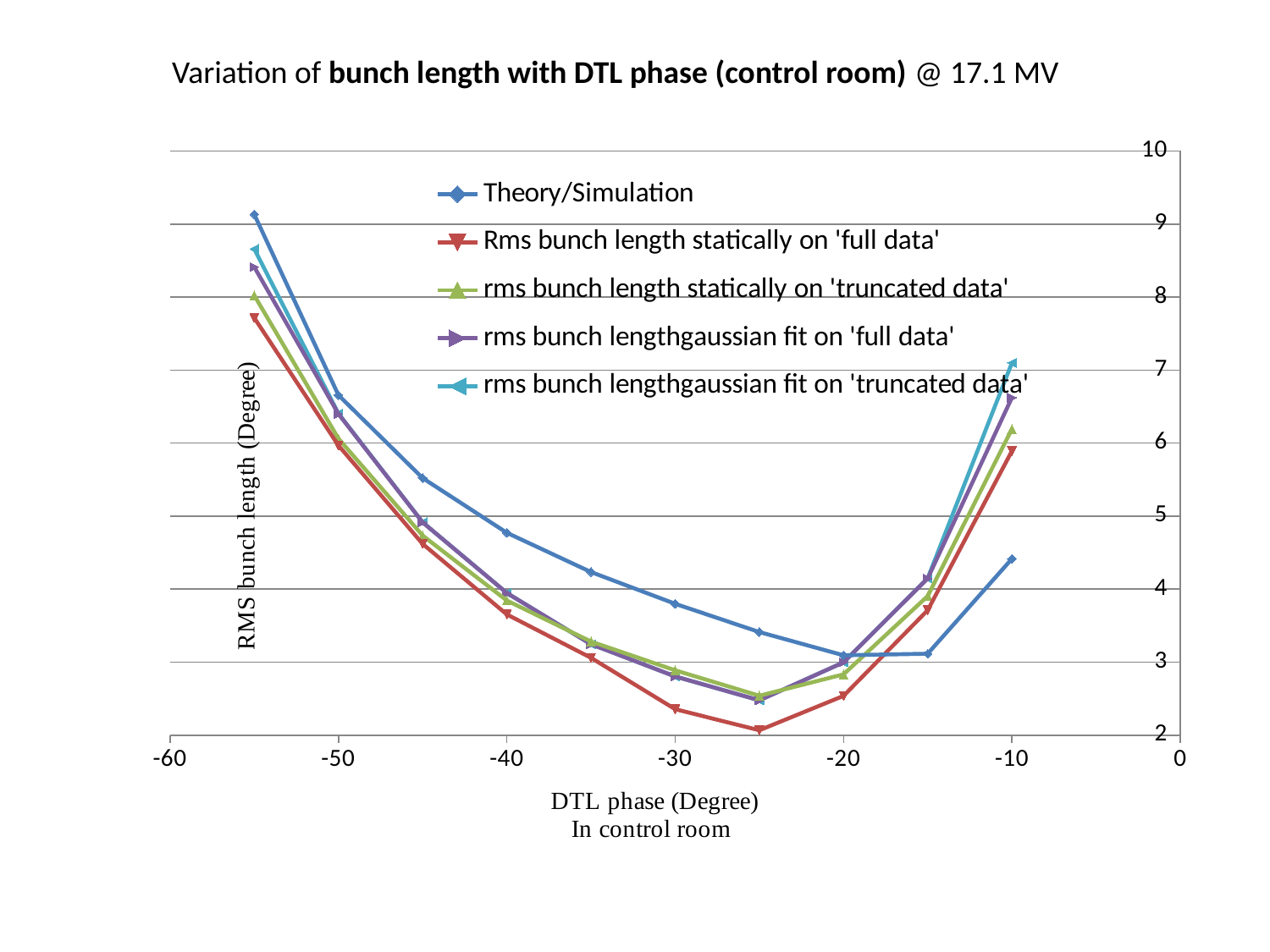
Is the Theory/Simulation value at a DTL phase of -10 greater or less than 4? greater What kind of chart is shown on the slide? line chart Is the value of 'Rms bunch length statically on full data' at a DTL phase of -25 greater or less than 3? less Which series has the highest value at a DTL phase of -55? Theory/Simulation Is the Theory/Simulation value at a DTL phase of -50 greater or less than 6? greater What is the label of the x axis? DTL phase (Degree) In control room How many series does the legend list? 5 Which series has the lowest value at a DTL phase of -25? Rms bunch length statically on 'full data' How many data points does the Theory/Simulation series have? 10 Does the Theory/Simulation series rise or fall as the DTL phase goes from -55 to -25? fall At a DTL phase of -10, which is larger: the Theory/Simulation value or the 'rms bunch length gaussian fit on truncated data' value? rms bunch length gaussian fit on 'truncated data'